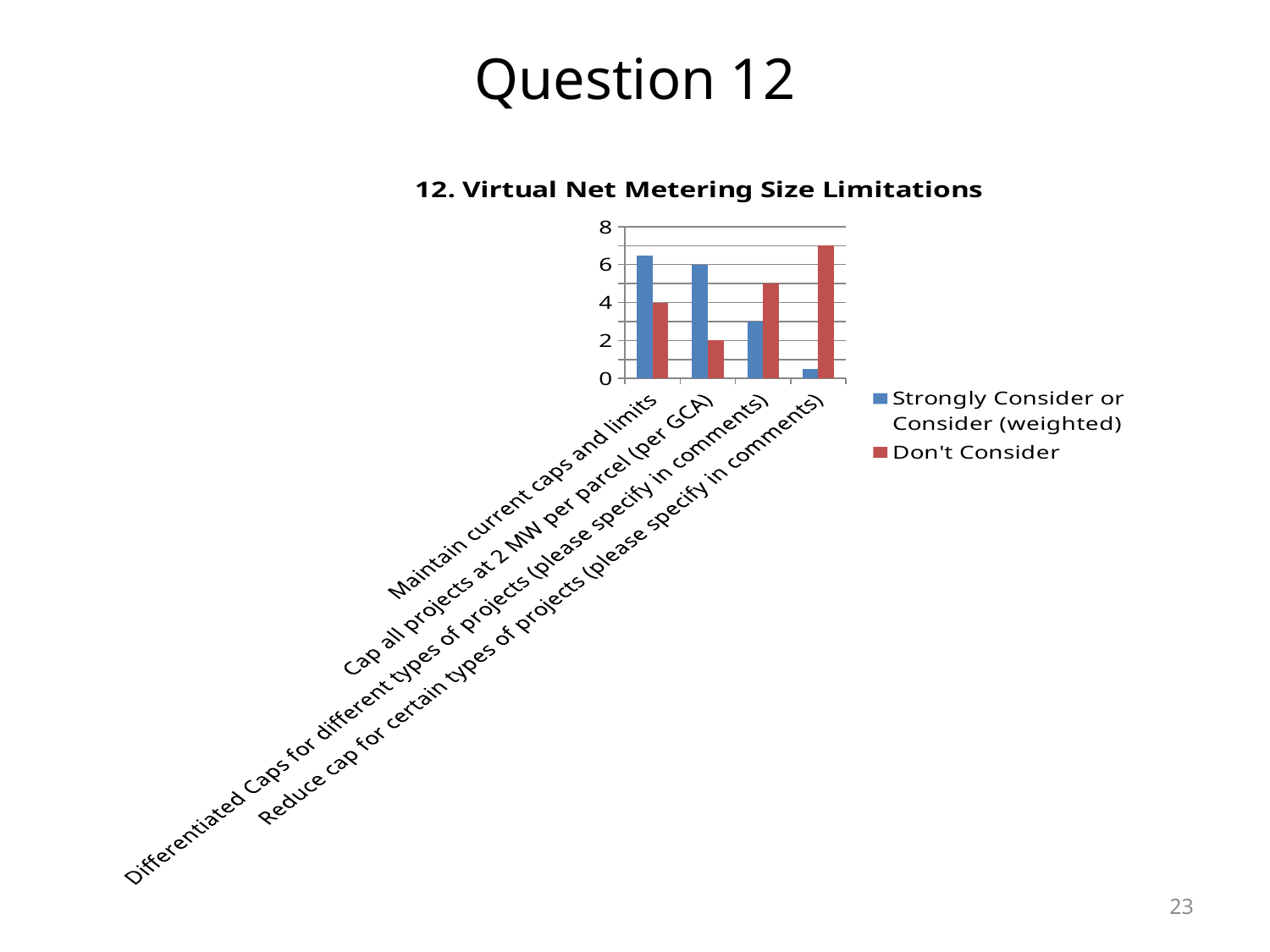
Is the 'Strongly Consider or Consider (weighted)' value for 'Differentiated Caps for different types of projects (please specify in comments)' greater or less than 4? less For 'Maintain current caps and limits', which series has the larger value? Strongly Consider or Consider (weighted) What colour represents the 'Don't Consider' series? red What kind of chart is shown on the slide? bar chart For 'Differentiated Caps for different types of projects (please specify in comments)', which series has the larger value? Don't Consider Which category has the lowest 'Strongly Consider or Consider (weighted)' value? Reduce cap for certain types of projects (please specify in comments) How many series does the legend list? 2 What is the 'Don't Consider' value for 'Maintain current caps and limits'? 4 Is the 'Don't Consider' value for 'Reduce cap for certain types of projects (please specify in comments)' greater or less than 6? greater What is the title of the chart? 12. Virtual Net Metering Size Limitations How many categories are shown on the x axis? 4 Which category has the highest 'Don't Consider' value? Reduce cap for certain types of projects (please specify in comments)